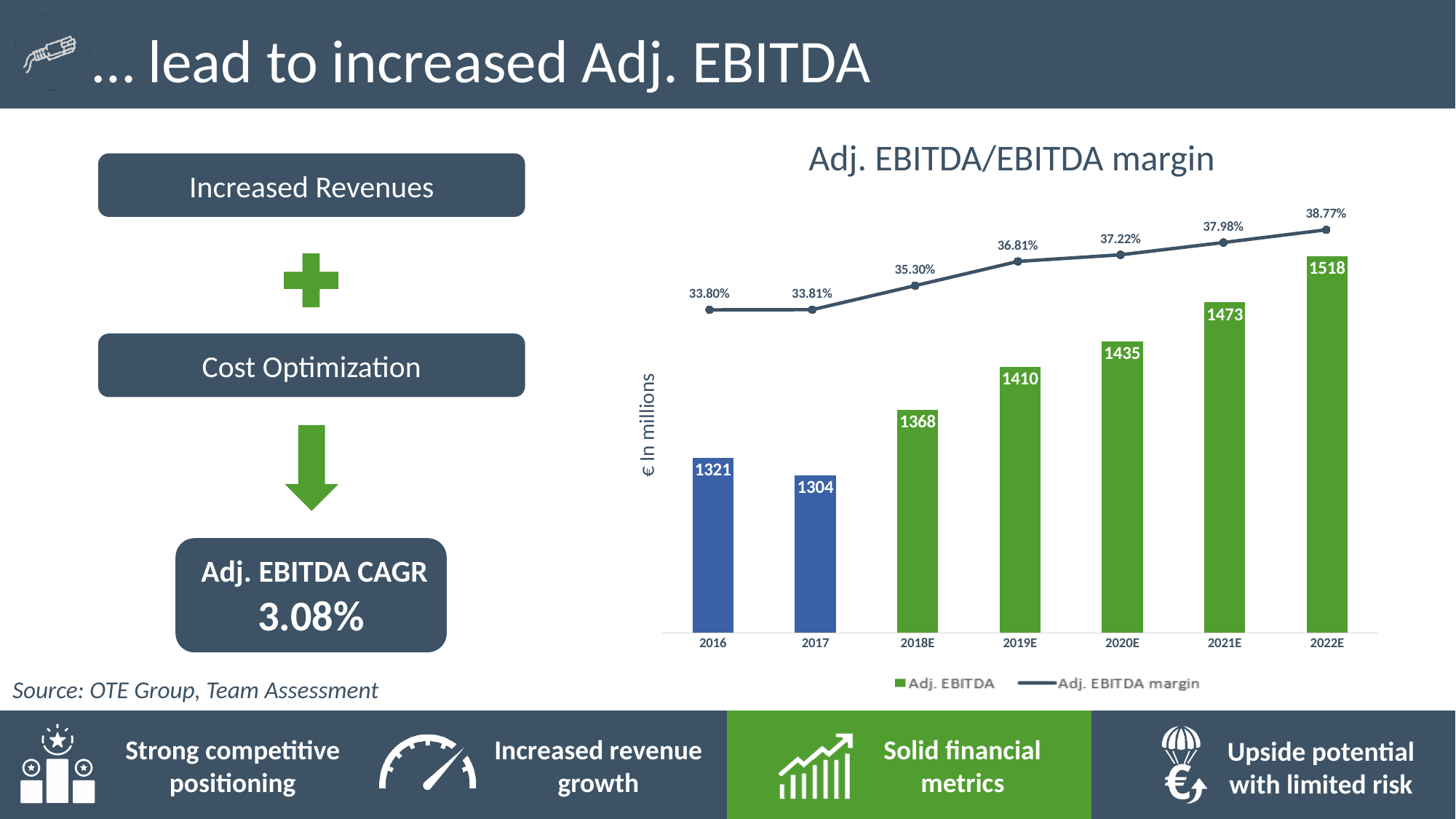
Which year has the lowest Adj. EBITDA? 2017 What is the title of the chart? Adj. EBITDA/EBITDA margin Which year has the highest Adj. EBITDA? 2022E What unit is shown on the vertical axis label of the chart? € In millions What is the Adj. EBITDA margin for 2021E? 37.98% Does the Adj. EBITDA margin rise or fall from 2017 to 2022E? Rise What kind of chart is used to show Adj. EBITDA? Bar chart What is the Adj. EBITDA value for 2019E? 1410 How many years are shown on the x axis of the chart? 7 Which is larger, the Adj. EBITDA for 2016 or for 2017? 2016 How many series does the legend list? 2 What is the difference in Adj. EBITDA between 2022E and 2016? 197